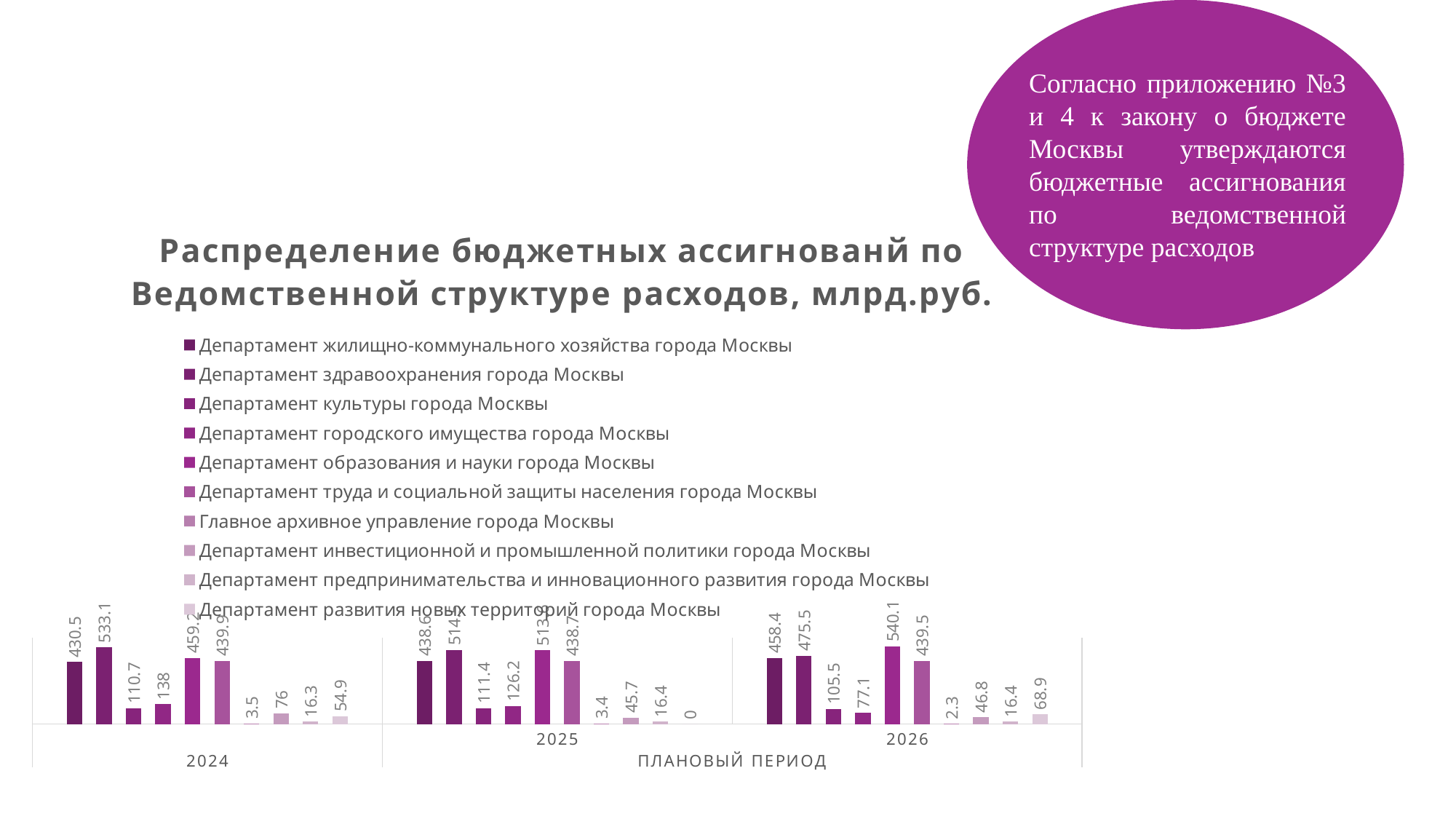
What is the value for Департамент развития новых территорий города Москвы in 2025? 0 How many year categories are shown on the x axis? 3 What is the value for Департамент предпринимательства и инновационного развития города Москвы in 2025? 16.4 What is the difference between the values for Департамент здравоохранения города Москвы in 2024 and 2026? 57.6 Which department has the lowest value in 2024? Главное архивное управление города Москвы What kind of chart is shown on the slide? bar chart How many series does the legend list? 10 What is the value for Департамент образования и науки города Москвы in 2026? 540.1 Which is larger in 2026: the value for Департамент культуры города Москвы or Департамент городского имущества города Москвы? Департамент культуры города Москвы Which department has the highest value in 2026? Департамент образования и науки города Москвы What is the value for Департамент здравоохранения города Москвы in 2024? 533.1 How does the value for Департамент городского имущества города Москвы change from 2024 to 2026? falls